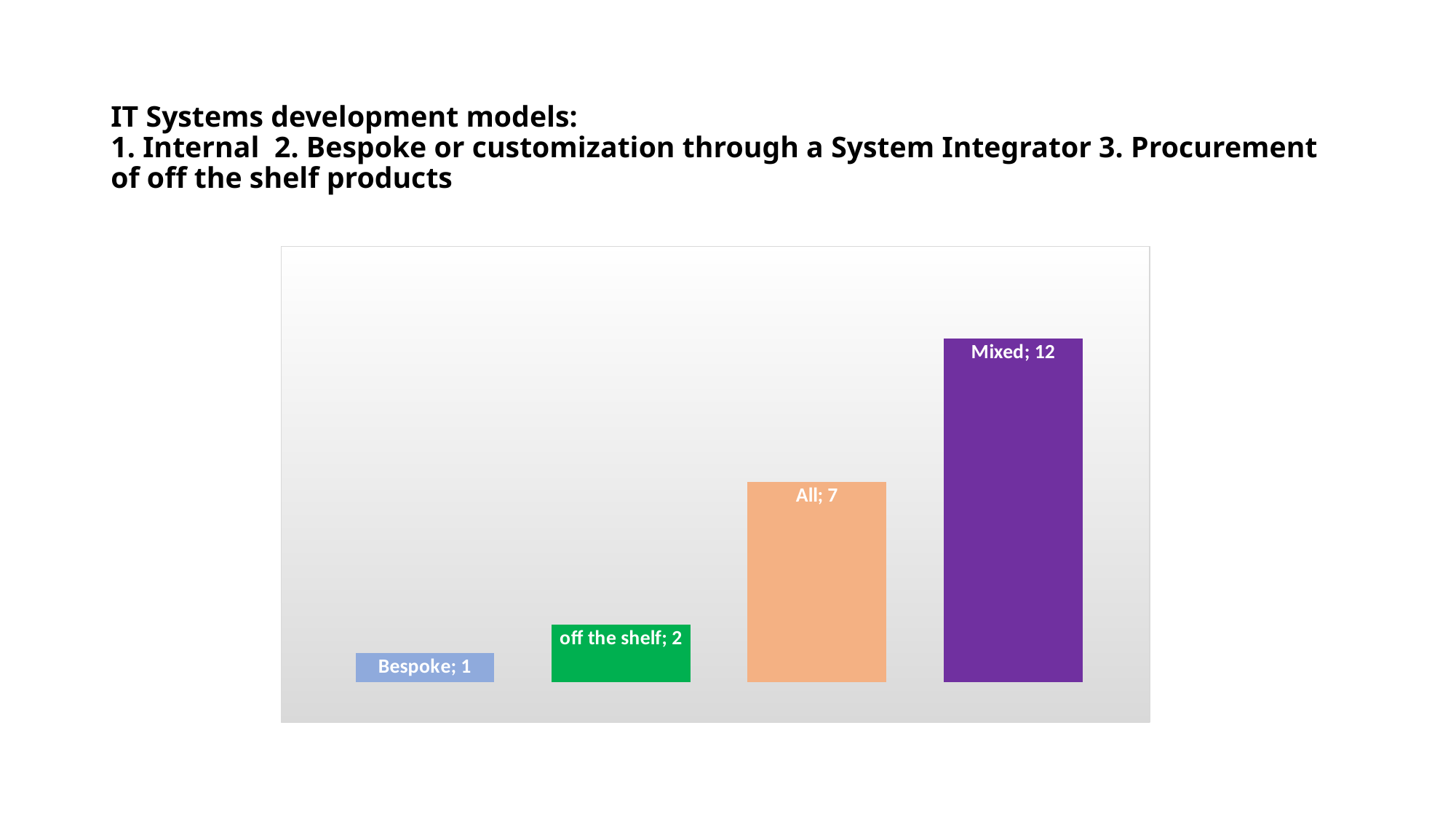
Which is larger, the value for All or the value for off the shelf? All Which category has the lowest value? Bespoke Which category has the highest value? Mixed What kind of chart is shown on the slide? Bar chart What is the value for off the shelf? 2 Do the values rise or fall from left to right across the categories? Rise What is the difference between the values for Mixed and All? 5 What is the value for Bespoke? 1 What is the value for Mixed? 12 What is the difference between the values for off the shelf and Bespoke? 1 How many categories are shown in the chart? 4 What is the value for All? 7